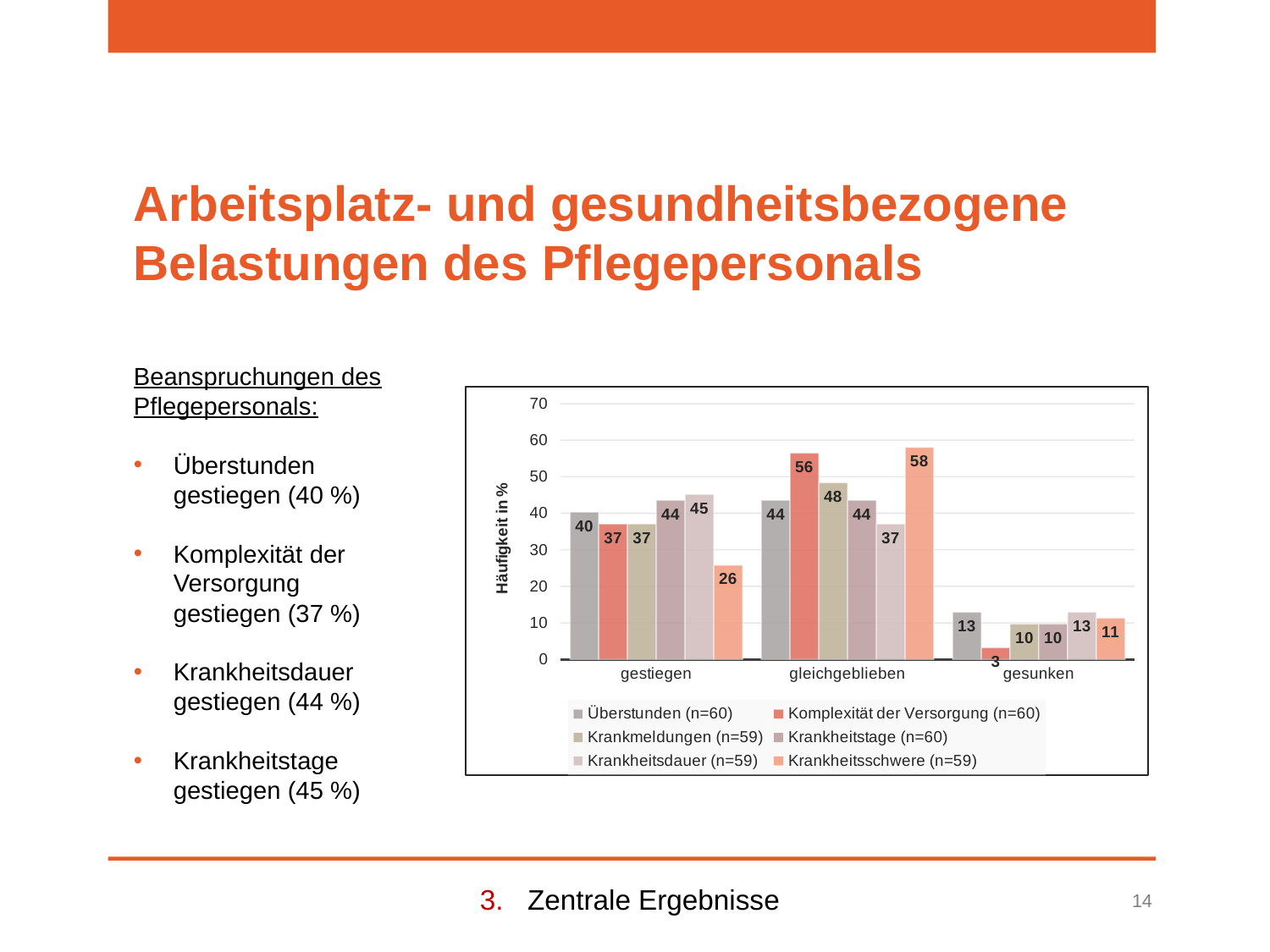
What is the value for Krankheitsschwere (n=59) in the 'gleichgeblieben' category? 58 What type of chart is shown on the slide? bar chart How many series does the chart legend list? 6 What is the label of the y axis of the chart? Häufigkeit in % What is the difference between the Krankheitsschwere (n=59) value and the Krankheitsdauer (n=59) value in the 'gleichgeblieben' category? 21 What is the value for Überstunden (n=60) in the 'gestiegen' category? 40 Which series has the lowest value in the 'gestiegen' category? Krankheitsschwere (n=59) What is the value for Komplexität der Versorgung (n=60) in the 'gesunken' category? 3 Which series has the highest value in the 'gleichgeblieben' category? Krankheitsschwere (n=59) How many categories are shown on the x axis of the chart? 3 Is the value for Komplexität der Versorgung (n=60) in the 'gleichgeblieben' category greater or less than 50? greater In the 'gestiegen' category, which is larger: the value for Krankheitsdauer (n=59) or the value for Krankheitstage (n=60)? Krankheitsdauer (n=59)